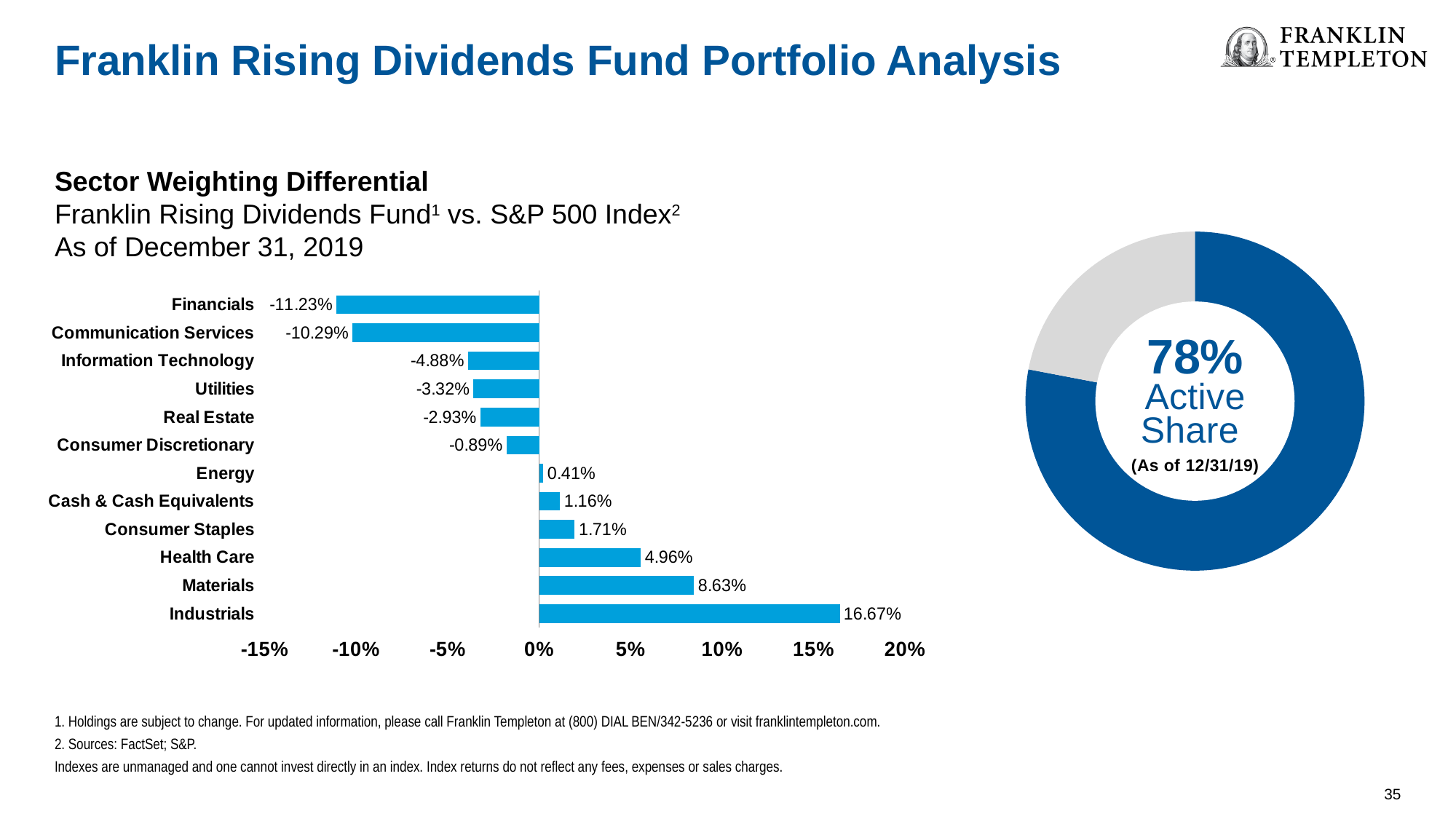
In the Sector Weighting Differential bar chart, which is larger, the value for Consumer Staples or the value for Cash & Cash Equivalents? Consumer Staples In the Sector Weighting Differential bar chart, what is the difference between the values for Industrials and Materials? 8.04% In the donut chart on the right, what is the Active Share percentage shown? 78% In the Sector Weighting Differential bar chart, which sector has the lowest value? Financials In the Sector Weighting Differential bar chart, which sector has the highest value? Industrials How many sectors are shown in the Sector Weighting Differential bar chart? 12 In the Sector Weighting Differential bar chart, is the value for Materials greater or less than 5%? greater In the Sector Weighting Differential bar chart, what is the value for Health Care? 4.96% In the Sector Weighting Differential bar chart, what is the value for Financials? -11.23% In the Sector Weighting Differential bar chart, what is the value for Industrials? 16.67% In the Sector Weighting Differential bar chart, what is the value for Communication Services? -10.29% What kind of chart is the Sector Weighting Differential chart? bar chart